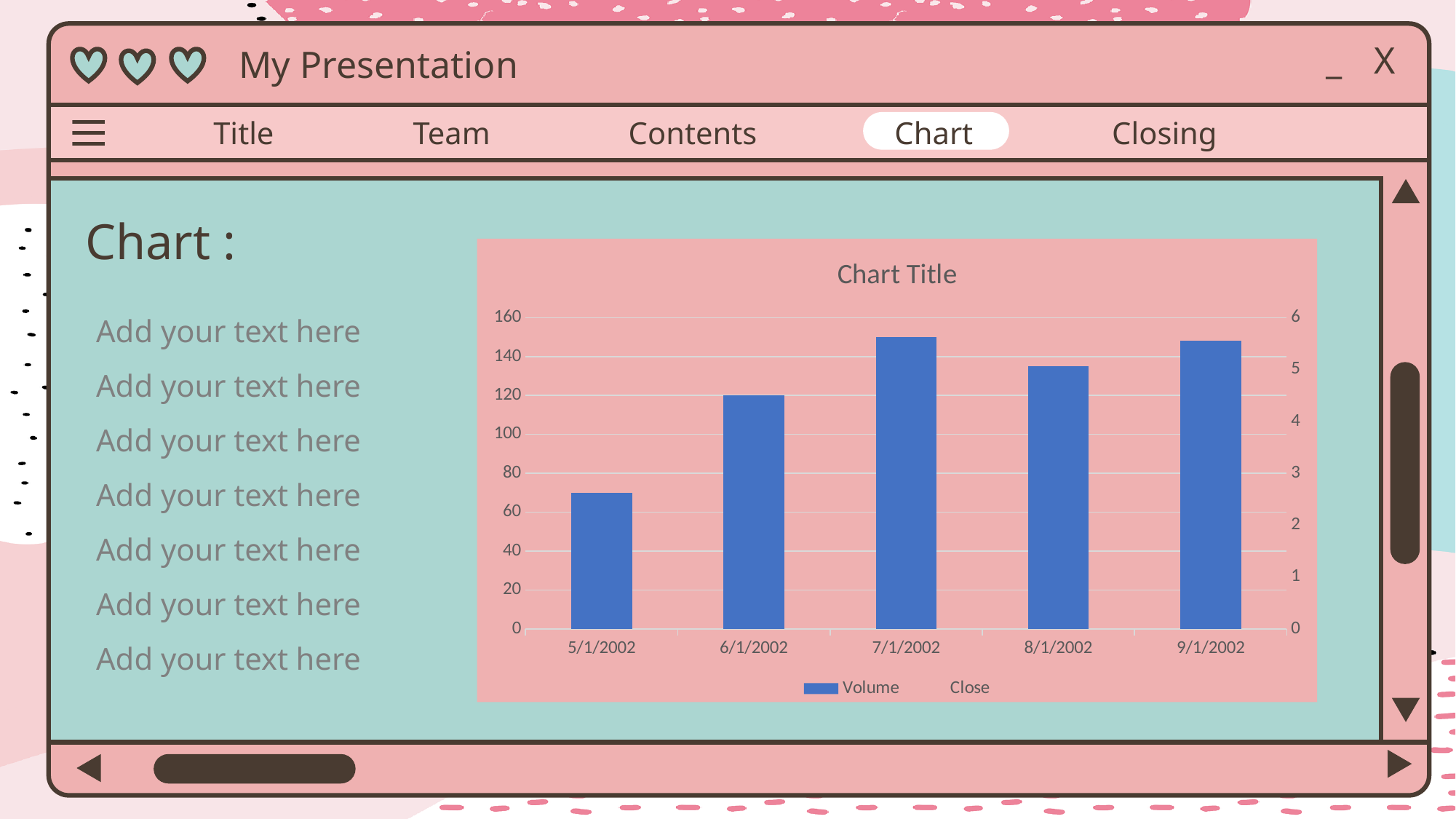
Which date has the lowest Volume? 5/1/2002 What colour are the Volume bars in the chart? blue What is the Volume value for 6/1/2002? 120 Is the Volume for 8/1/2002 greater or less than 120? greater Is the Volume for 5/1/2002 greater or less than 80? less Which has the larger Volume, 6/1/2002 or 8/1/2002? 8/1/2002 Is the Volume for 7/1/2002 greater or less than 140? greater Does the Volume rise or fall from 5/1/2002 to 7/1/2002? rise How many series does the chart legend list? 2 What type of chart is shown on the slide? bar chart What is the title of the chart? Chart Title How many dates are shown on the x axis of the chart? 5